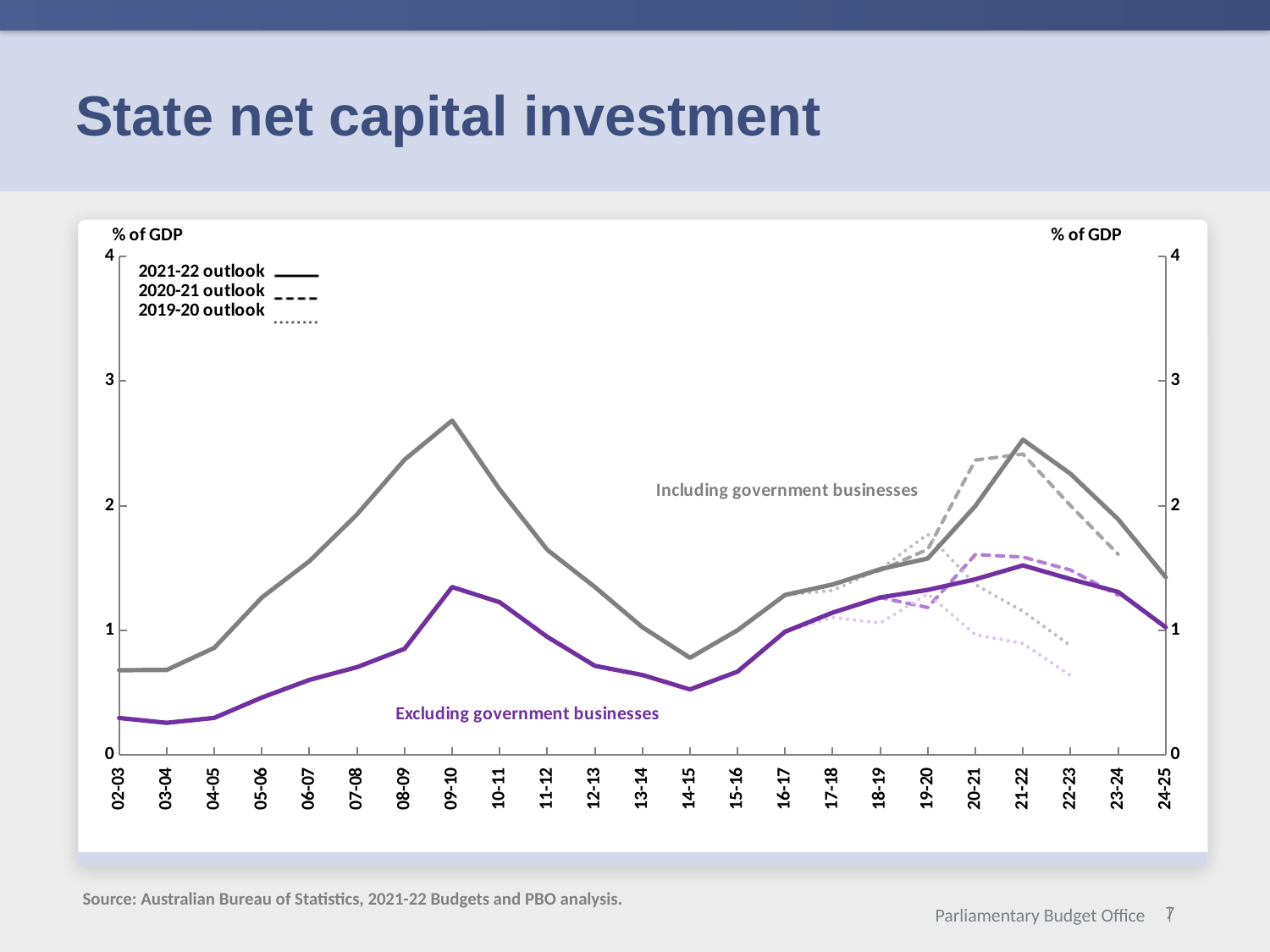
Is the value of the 'Including government businesses' line in 09-10 greater or less than 2? greater In which year does the 'Including government businesses' line reach its highest value? 09-10 Is the value of the 'Excluding government businesses' line in 02-03 greater or less than 1? less Is the value of the 'Excluding government businesses' line in 09-10 greater or less than 1? greater Does the 'Excluding government businesses' line rise or fall from 21-22 to 24-25? fall How many outlooks does the legend list? 3 How many financial years are shown along the x axis? 23 What kind of chart is shown on the slide? line chart Which line is higher in 09-10, 'Including government businesses' or 'Excluding government businesses'? Including government businesses What is the title of the chart? State net capital investment What is the unit shown on the vertical axis? % of GDP